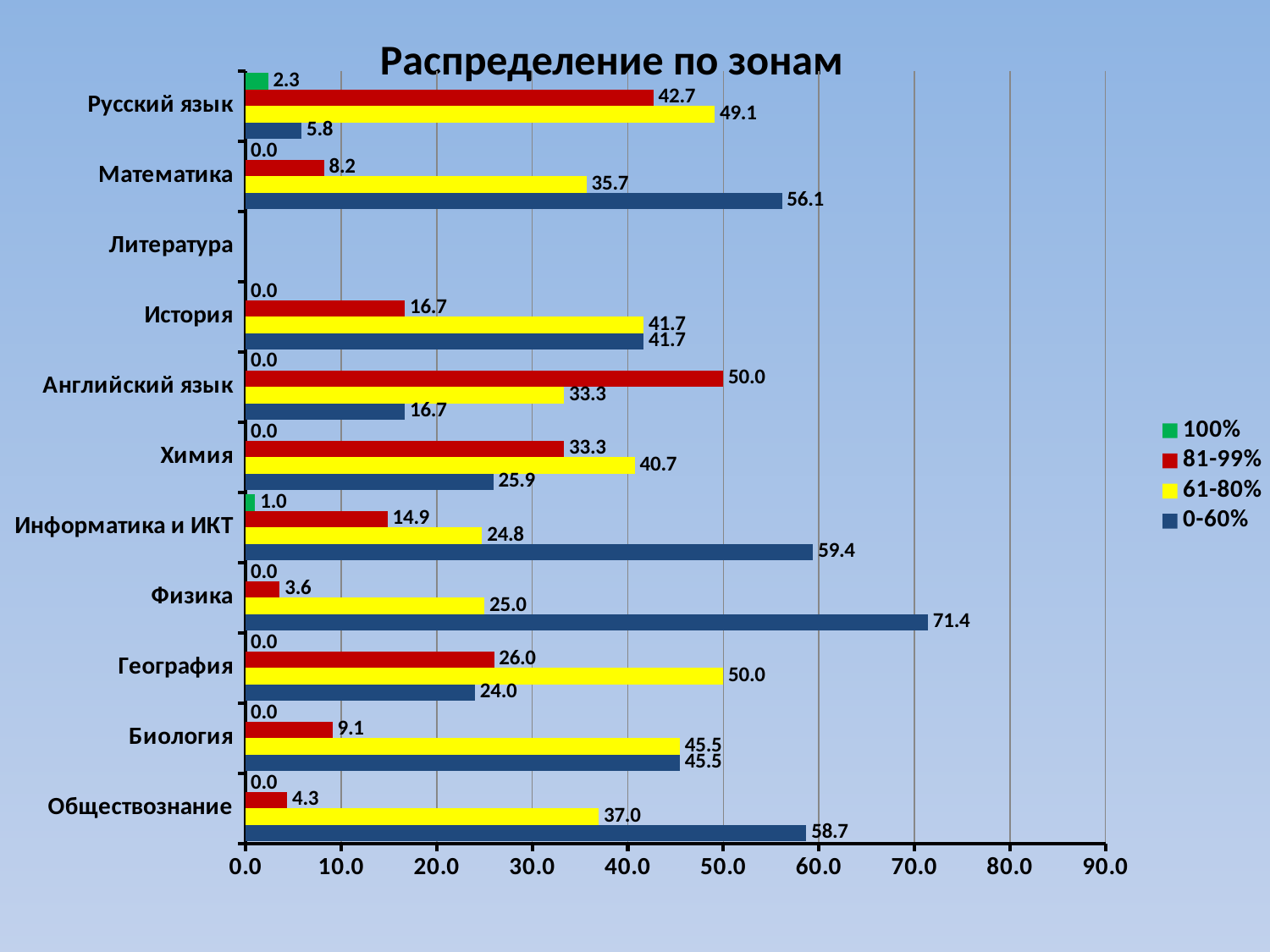
How many categories are listed on the vertical axis? 11 What is the value of the 0-60% series for Физика? 71.4 Which category has the highest value in the 100% series? Русский язык What is the value of the 81-99% series for Английский язык? 50.0 What type of chart is shown on the slide? Bar chart How many series does the legend list? 4 What is the difference between the 0-60% value for Информатика и ИКТ and the 0-60% value for Математика? 3.3 What is the value of the 61-80% series for Русский язык? 49.1 Is the 0-60% value for Обществознание greater or less than 50.0? greater Which is larger for Химия: the 81-99% value or the 61-80% value? 61-80% What is the value of the 100% series for Информатика и ИКТ? 1.0 Which category has the highest value in the 0-60% series? Физика